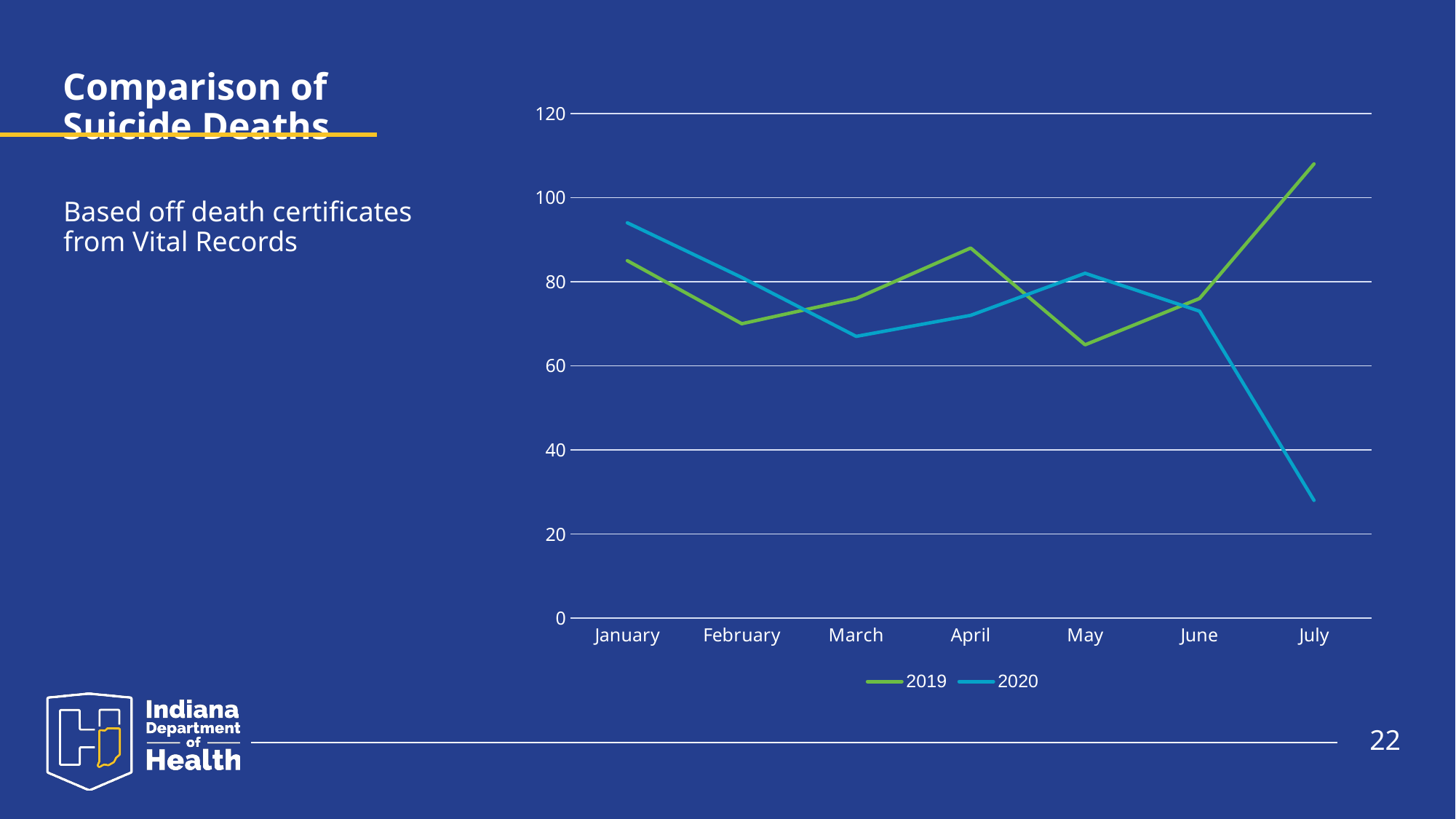
Does the 2020 line rise or fall from May to July? fall How many months are shown on the x axis? 7 Is the 2020 value for July greater or less than 40? less In January, which series has the higher value, 2019 or 2020? 2020 In which month is the 2020 line at its lowest? July Is the 2019 value for July greater or less than 100? greater Which series does the legend list besides 2019? 2020 What kind of chart is shown on the slide? line chart How many series does the legend list? 2 In which month is the 2020 line at its highest? January In July, which series has the higher value, 2019 or 2020? 2019 In which month is the 2019 line at its highest? July